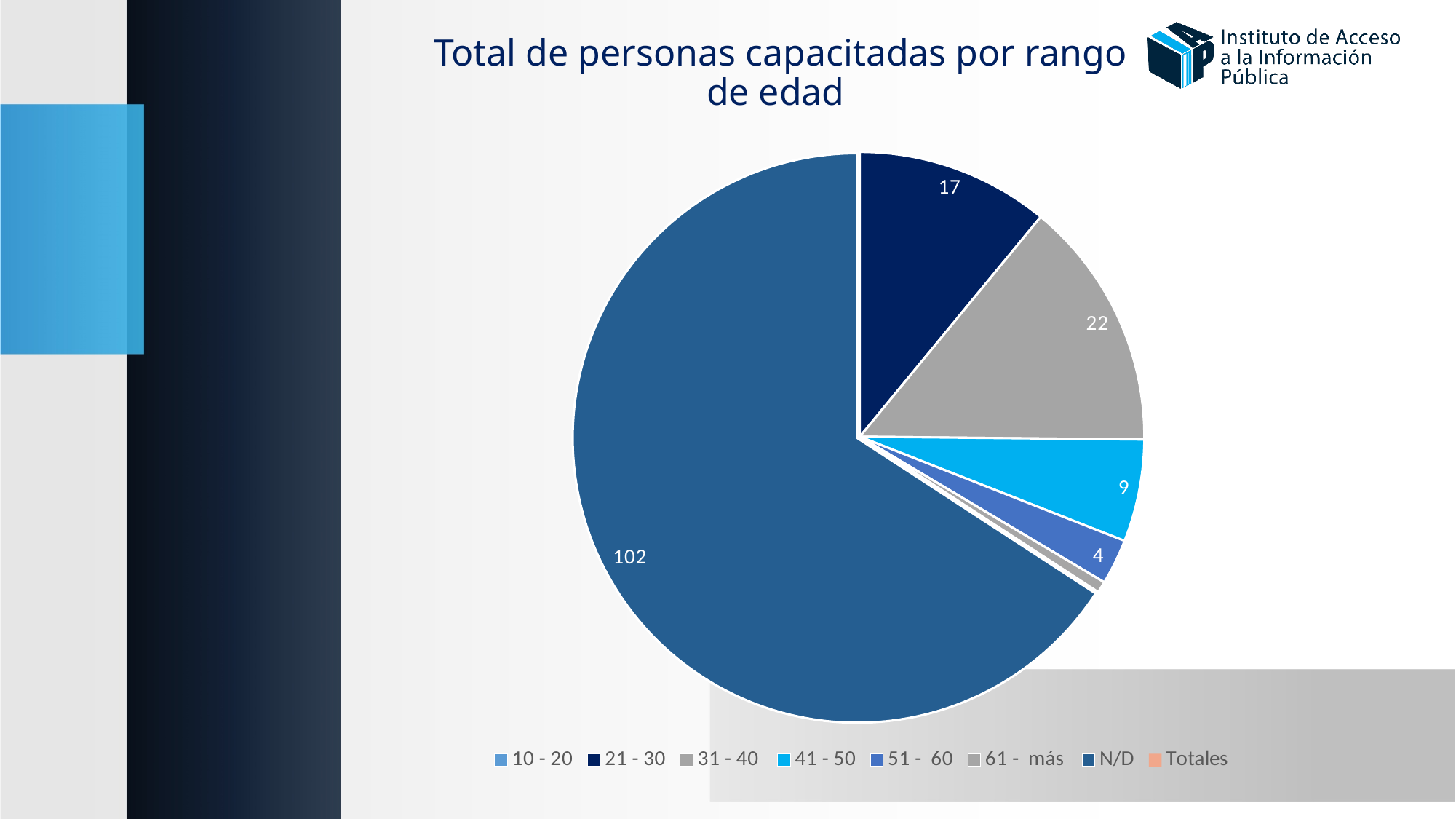
What is the value for the N/D category? 102 What is the value for the 21 - 30 age range? 17 What is the value for the 31 - 40 age range? 22 Which category has the largest slice of the pie? N/D How many entries does the legend list? 8 What is the difference between the value for 31 - 40 and the value for 21 - 30? 5 Which is larger, the value for 21 - 30 or the value for 31 - 40? 31 - 40 What is the value for the 51 - 60 age range? 4 What is the value for the 41 - 50 age range? 9 What is the title of the chart? Total de personas capacitadas por rango de edad What type of chart is shown on the slide? pie chart What is the difference between the value for N/D and the value for 31 - 40? 80